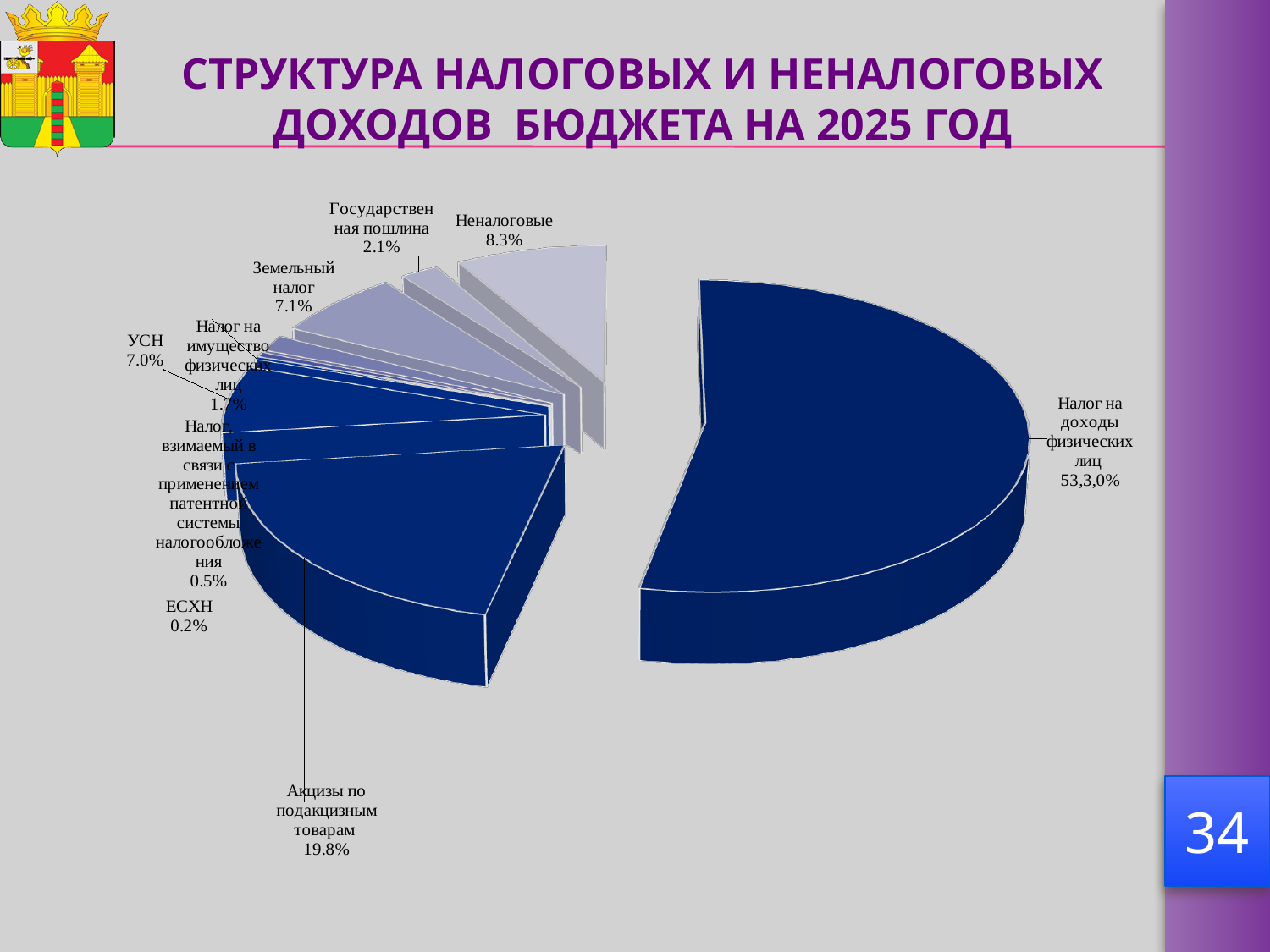
Which is larger, Земельный налог or УСН? Земельный налог How many slices does the pie chart have? 9 What share of the pie does Акцизы по подакцизным товарам account for? 19.8% Which category has the smallest slice of the pie? ЕСХН What type of chart is shown on the slide? Pie chart What percentage is shown for Государственная пошлина? 2.1% What percentage is shown for Земельный налог? 7.1% What is the difference in percentage points between Акцизы по подакцизным товарам and Неналоговые? 11.5 What is the value for ЕСХН? 0.2% What is the value for УСН? 7.0% What is the value shown for Неналоговые? 8.3% Which category has the largest slice of the pie? Налог на доходы физических лиц